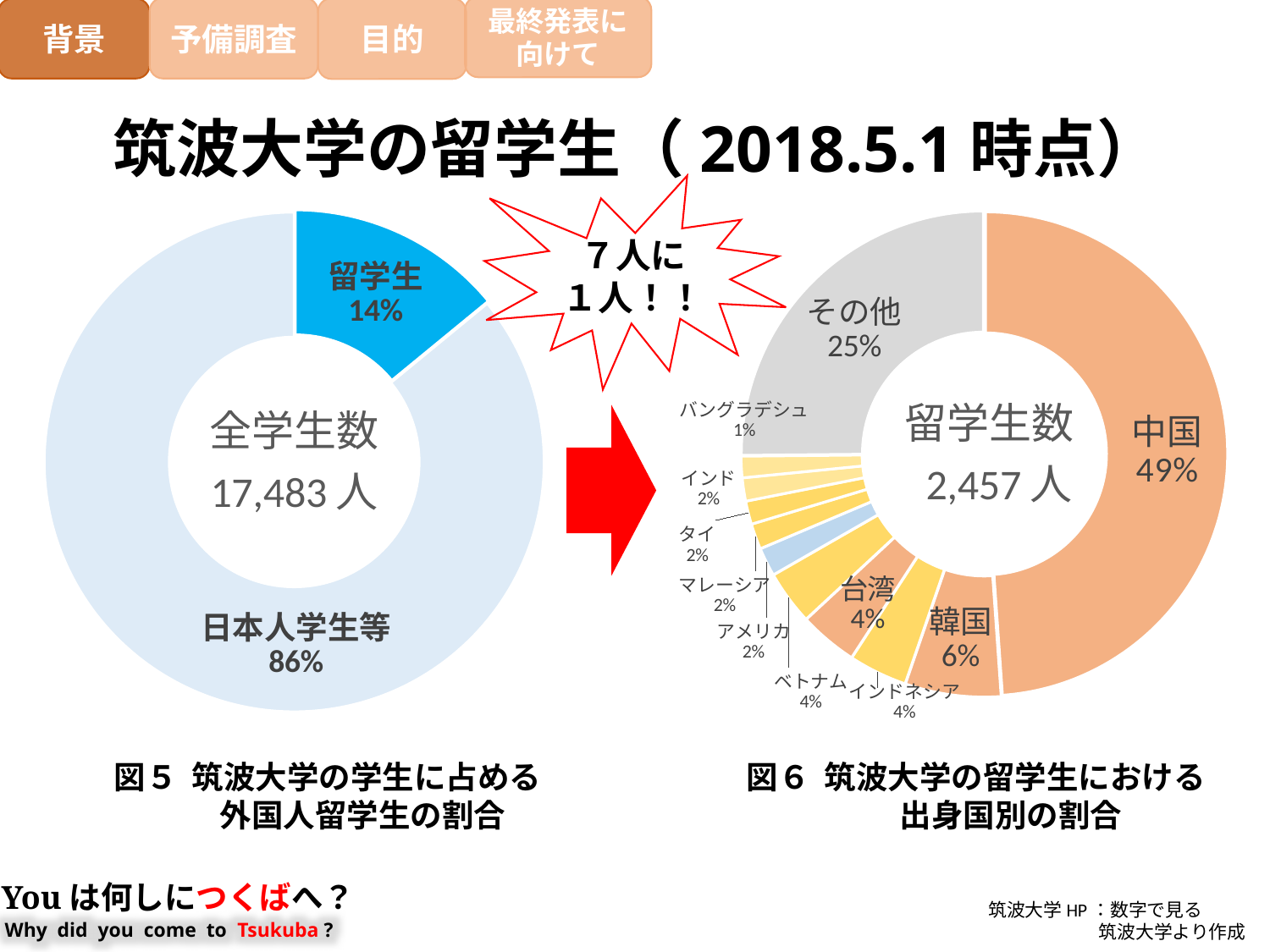
In the right chart (図6), which named country has the smallest share? バングラデシュ In the right chart (図6), what percentage is shown for その他? 25% In the left chart (図5), what percentage of students are 留学生? 14% In the right chart (図6), which is larger, the share for 台湾 or the share for 韓国? 韓国 How many categories are shown in the right chart (図6), including その他? 11 In the right chart (図6), which country has the largest share of international students? 中国 What type of chart is used for 図5 on the left? Donut (pie) chart In the left chart (図5), what is the total number of students shown in the centre (全学生数)? 17,483人 In the right chart (図6), what is the difference in percentage points between 中国 and 韓国? 43 In the right chart (図6), what percentage is shown for 韓国? 6% In the left chart (図5), what percentage is shown for 日本人学生等? 86% In the right chart (図6), what share of international students come from 中国? 49%